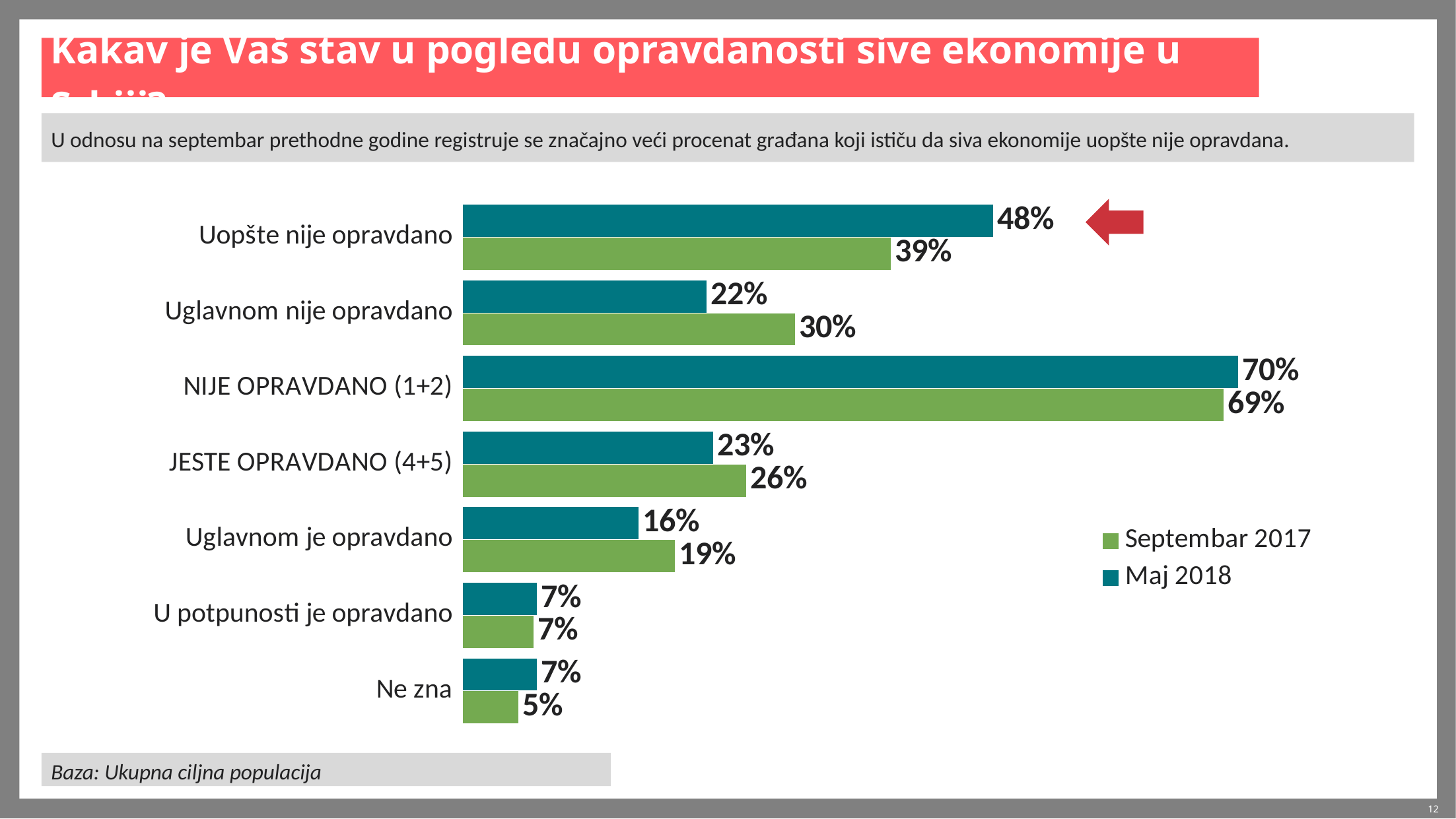
For "JESTE OPRAVDANO (4+5)", which series has the larger value, Septembar 2017 or Maj 2018? Septembar 2017 What is the difference between the Septembar 2017 and Maj 2018 values for "Uglavnom nije opravdano"? 8% What is the value for "Ne zna" in the Septembar 2017 series? 5% What kind of chart is shown on the slide? Bar chart Which series is shown in green in the legend? Septembar 2017 Which category has the highest value in the Maj 2018 series? NIJE OPRAVDANO (1+2) Which category has the lowest value in the Septembar 2017 series? Ne zna What is the difference between the Maj 2018 and Septembar 2017 values for "Uopšte nije opravdano"? 9% What is the value for "Uglavnom nije opravdano" in the Septembar 2017 series? 30% What is the value for "Uopšte nije opravdano" in the Maj 2018 series? 48% How many series does the legend list? 2 How many categories are shown on the chart? 7